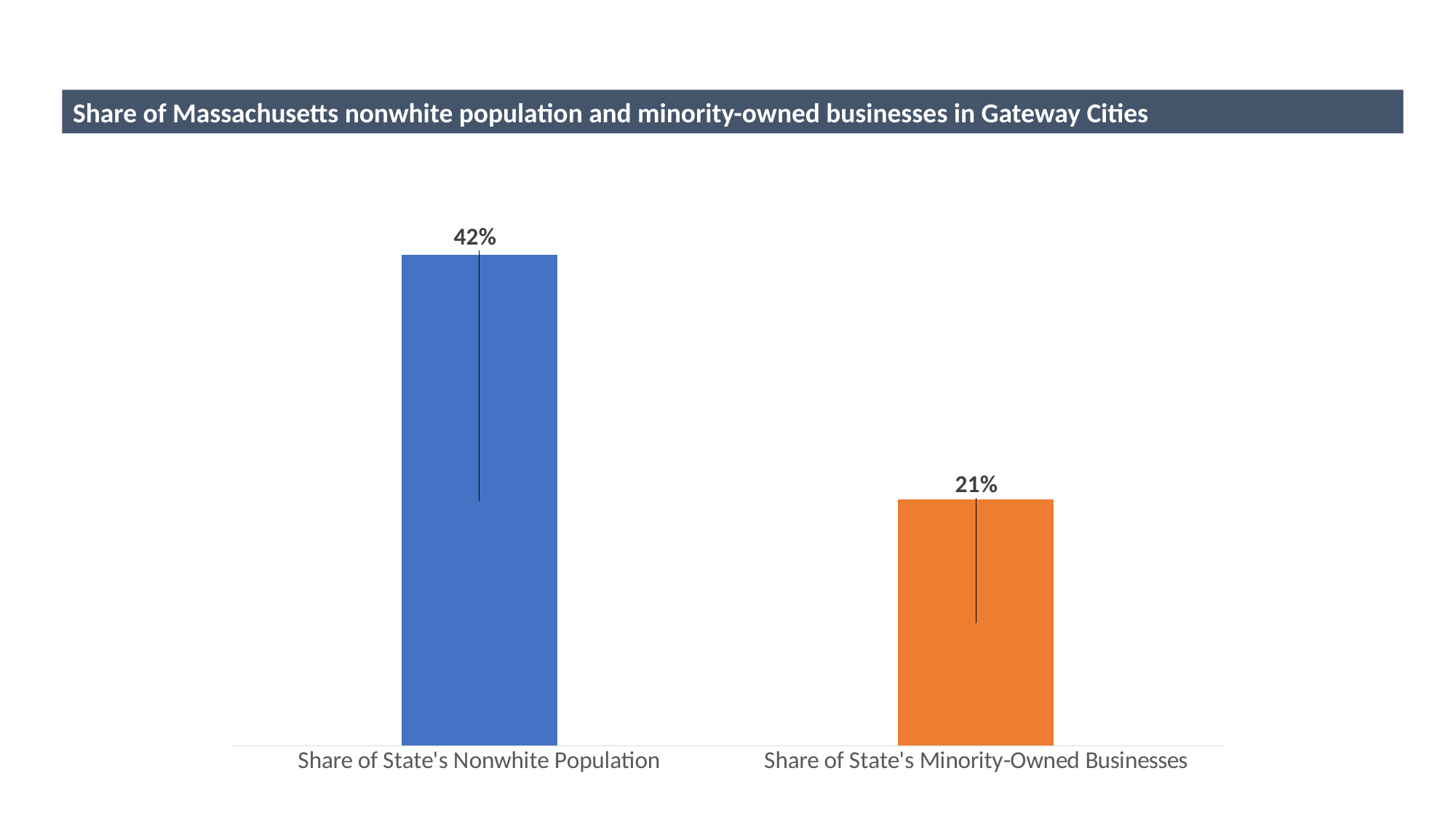
What is the value for Share of State's Minority-Owned Businesses? 21% What is the difference between the Share of State's Nonwhite Population and the Share of State's Minority-Owned Businesses? 21% What is the value for Share of State's Nonwhite Population? 42% Which category has the highest value? Share of State's Nonwhite Population Which is larger: Share of State's Nonwhite Population or Share of State's Minority-Owned Businesses? Share of State's Nonwhite Population How many categories are shown in the chart? 2 What kind of chart is shown on the slide? Bar chart Which category has the lowest value? Share of State's Minority-Owned Businesses What colour is the bar for Share of State's Minority-Owned Businesses? Orange What is the title of the chart? Share of Massachusetts nonwhite population and minority-owned businesses in Gateway Cities